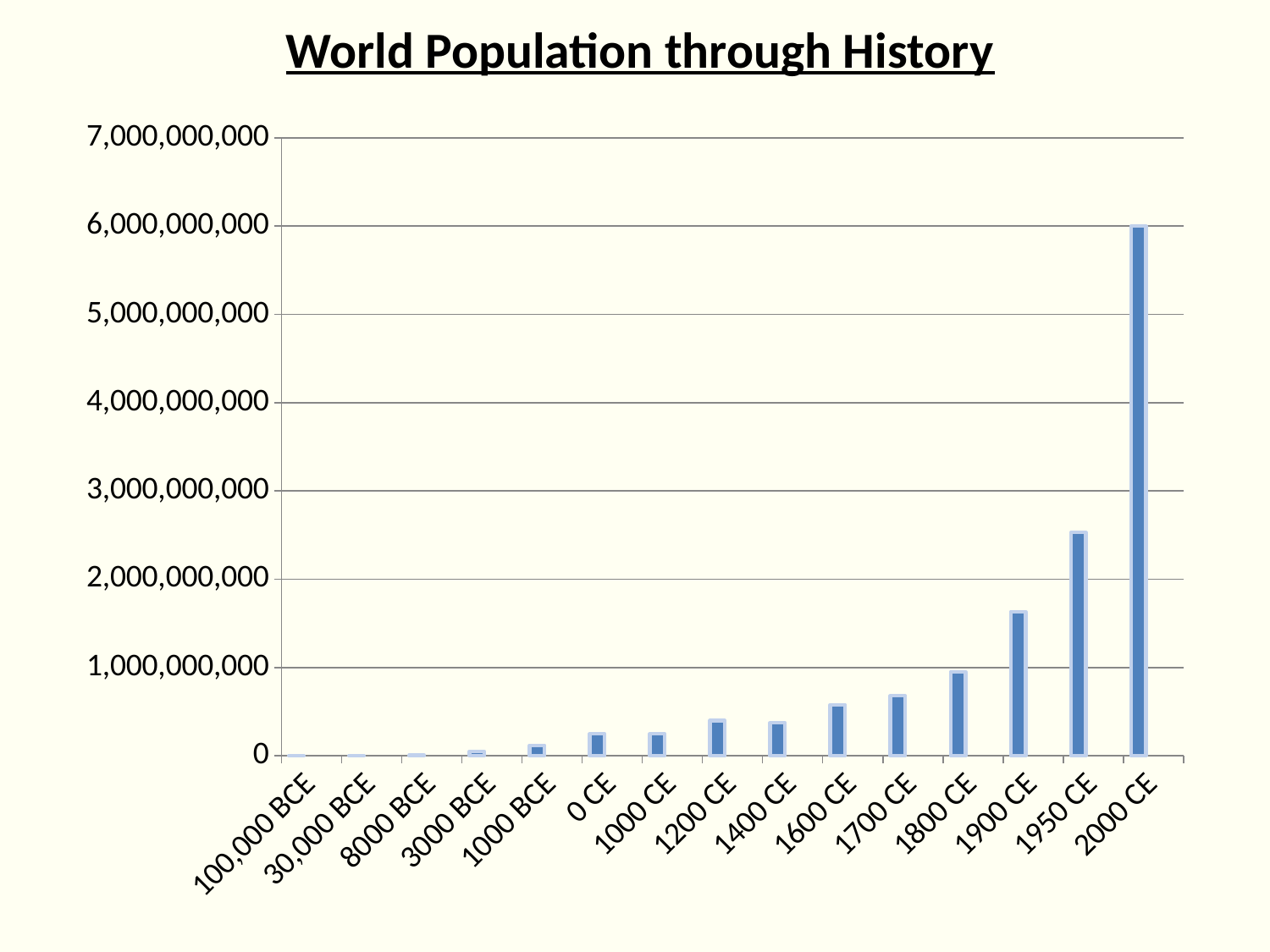
Is the value for 1950 CE greater or less than 2,000,000,000? greater How many categories (time points) are shown on the x axis? 15 Do the values generally rise or fall moving from left to right along the x axis? rise Which is larger, the value for 1950 CE or the value for 1900 CE? 1950 CE What is the title of the chart? World Population through History Is the value for 1900 CE greater or less than 1,000,000,000? greater What kind of chart is shown on the slide? bar chart What is the world population value shown for 2000 CE? 6,000,000,000 Which is larger, the value for 1600 CE or the value for 1400 CE? 1600 CE Is the value for 1900 CE greater or less than 2,000,000,000? less Which category has the highest world population? 2000 CE